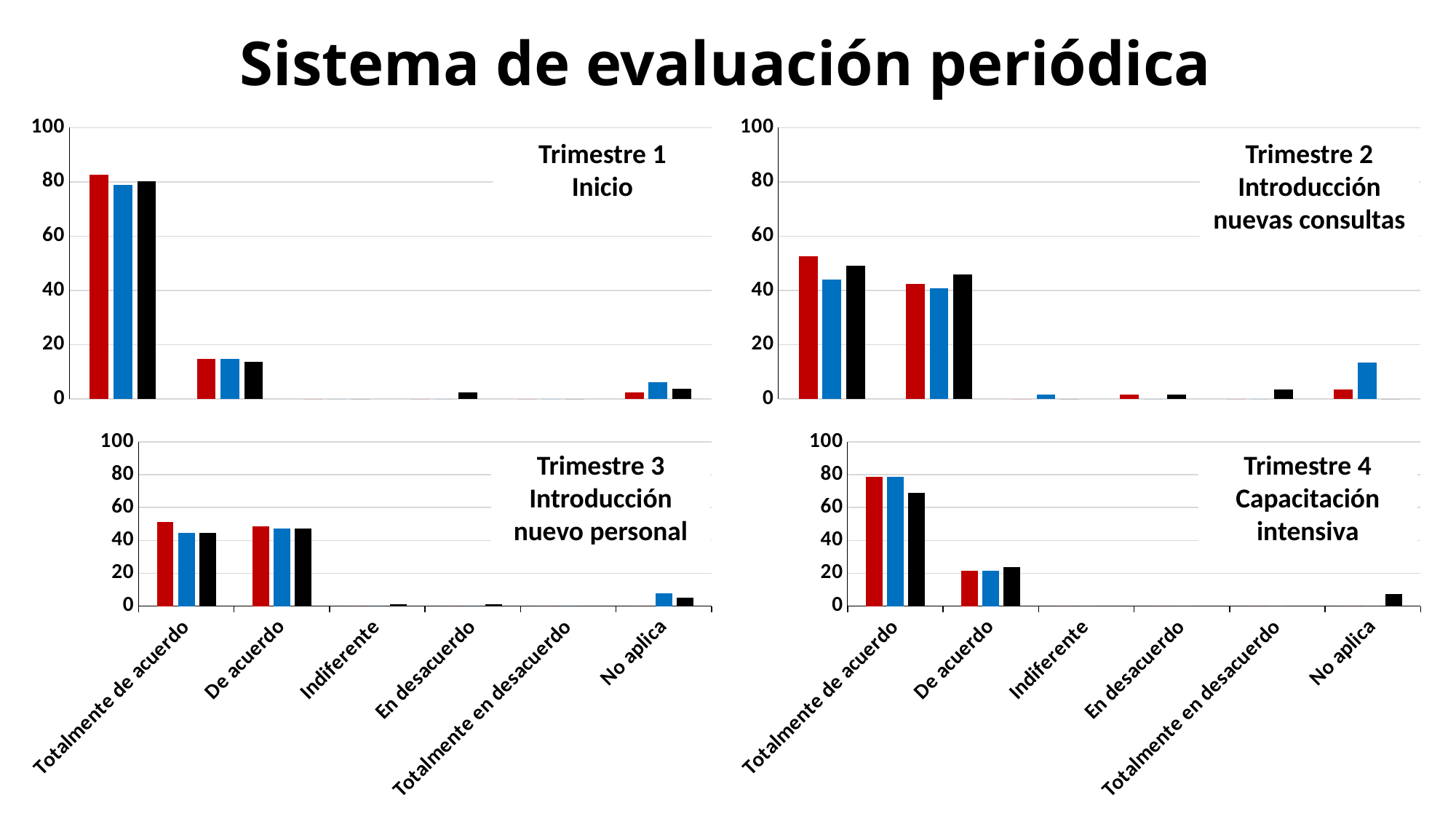
In the Trimestre 1 Inicio chart, is the red bar for Totalmente de acuerdo greater or less than 60? greater In the Trimestre 4 Capacitación intensiva chart, is the black bar for De acuerdo greater or less than 40? less In the Trimestre 1 Inicio chart, which category has the tallest bars? Totalmente de acuerdo What kind of chart is used for Trimestre 1 Inicio? bar chart How many charts are shown on the slide? 4 In the Trimestre 1 Inicio chart, which is larger for the red bars: Totalmente de acuerdo or De acuerdo? Totalmente de acuerdo What is the title of the slide? Sistema de evaluación periódica In the Trimestre 4 Capacitación intensiva chart, is the black bar for Totalmente de acuerdo greater or less than 80? less In the Trimestre 2 Introducción nuevas consultas chart, which is larger for the red bars: Totalmente de acuerdo or De acuerdo? Totalmente de acuerdo How many categories are shown on the x axis of the Trimestre 4 Capacitación intensiva chart? 6